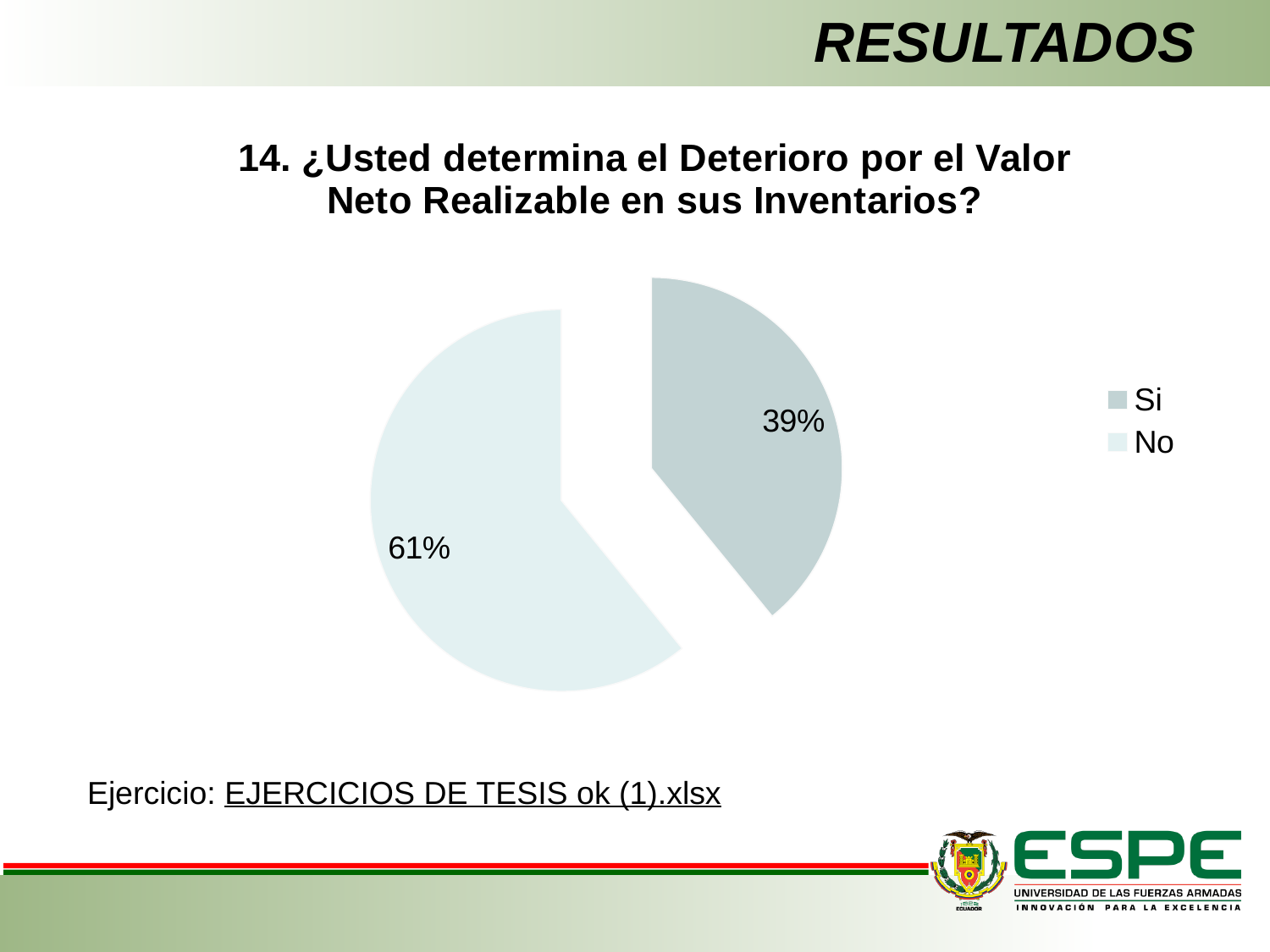
What percentage of respondents answered "No"? 61% What is the question number shown in the chart title? 14 What is the difference in percentage points between the "No" and "Si" slices? 22 What type of chart is shown on the slide? Pie chart Which response has the smallest share of the pie? Si How many slices does the pie chart have? 2 Which is larger, the share for "Si" or the share for "No"? No Which legend entry is listed first? Si What share of the pie does the "No" slice represent? 61% What percentage of respondents answered "Si"? 39% How many entries does the legend list? 2 Which response has the largest share of the pie? No